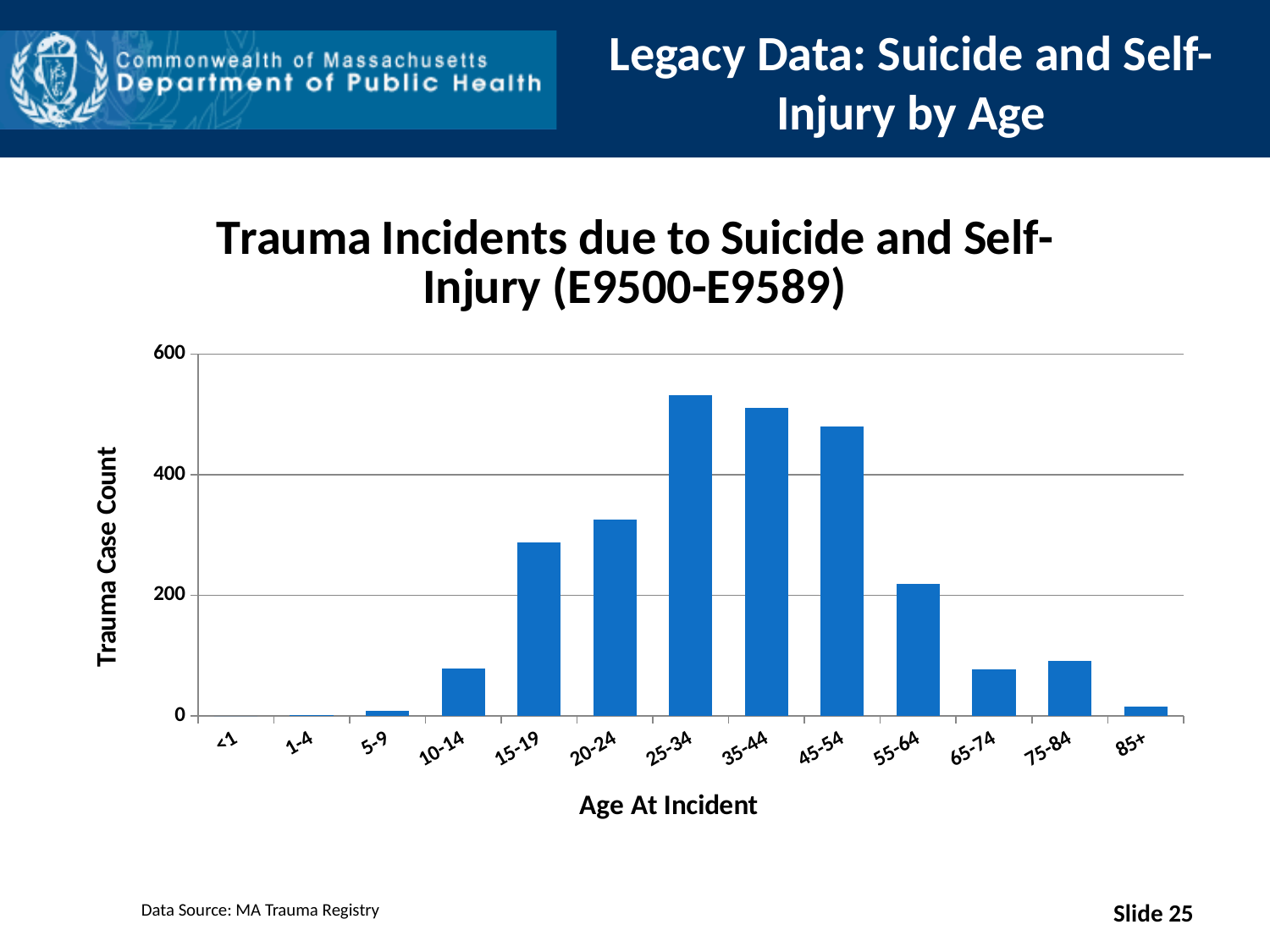
Is the value for the 85+ age group greater or less than 200? less Is the value for the 25-34 age group greater or less than 400? greater Do the values rise or fall from the 45-54 age group to the 85+ age group? fall Is the value for the 10-14 age group greater or less than 200? less Which has a higher trauma case count, the 45-54 age group or the 55-64 age group? 45-54 What type of chart is shown on the slide? bar chart What is the label of the y axis? Trauma Case Count Which has a higher trauma case count, the 20-24 age group or the 15-19 age group? 20-24 Which age group has the highest trauma case count? 25-34 How many age categories are shown on the x axis? 13